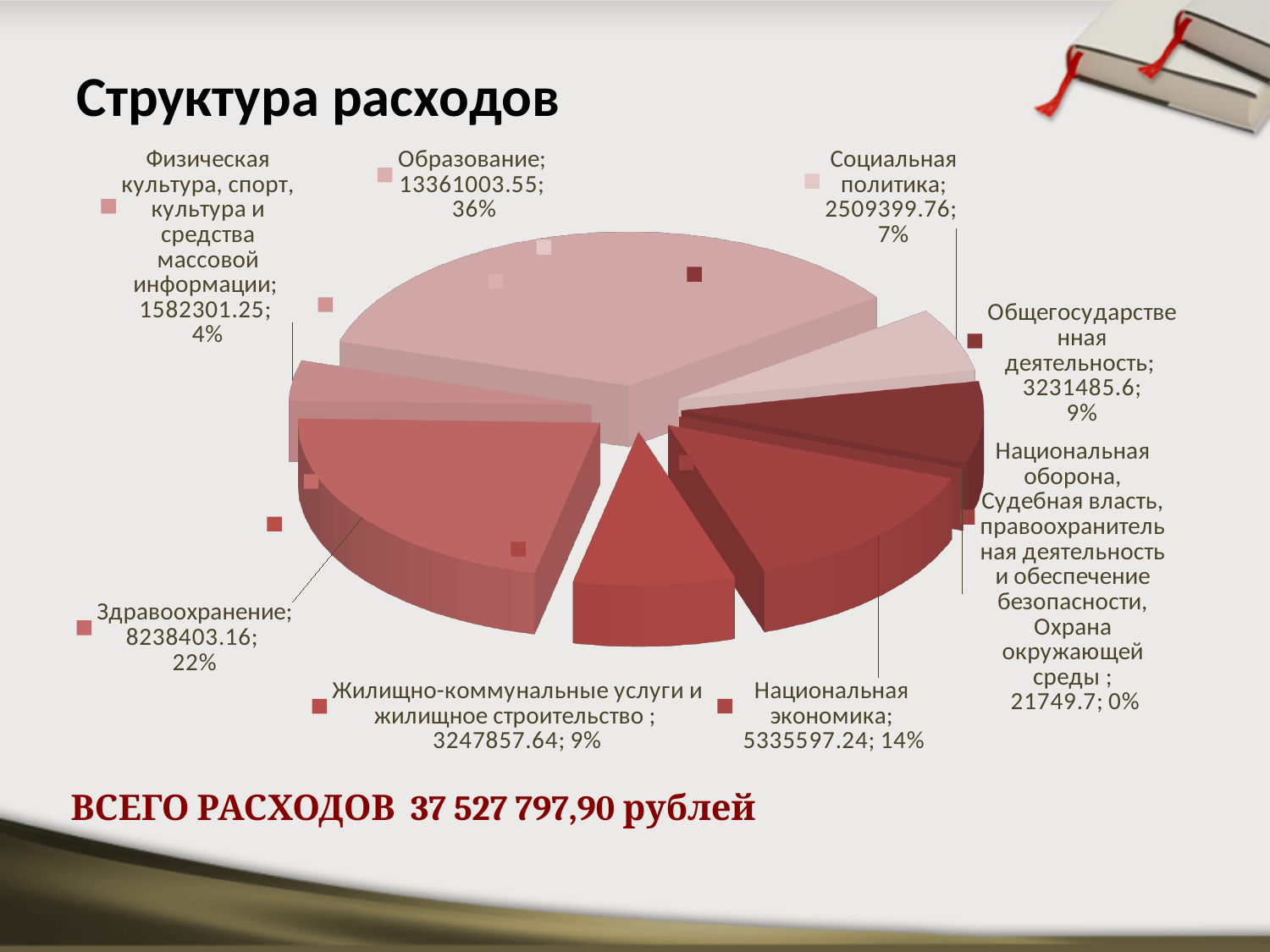
Which category has the smallest share of the pie? Национальная оборона, Судебная власть, правоохранительная деятельность и обеспечение безопасности, Охрана окружающей среды What is the difference between the value for Жилищно-коммунальные услуги и жилищное строительство and the value for Общегосударственная деятельность? 16372.04 What is the value for Национальная экономика? 5335597.24 What share of the pie does Социальная политика represent? 7% What share of the pie does Здравоохранение represent? 22% Which is larger, the value for Здравоохранение or the value for Национальная экономика? Здравоохранение What is the value for Физическая культура, спорт, культура и средства массовой информации? 1582301.25 How many categories (slices) does the pie chart have? 8 What is the value for Образование? 13361003.55 What kind of chart is shown on the slide? Pie chart Which category has the largest share of the pie? Образование What is the title of the chart? Структура расходов